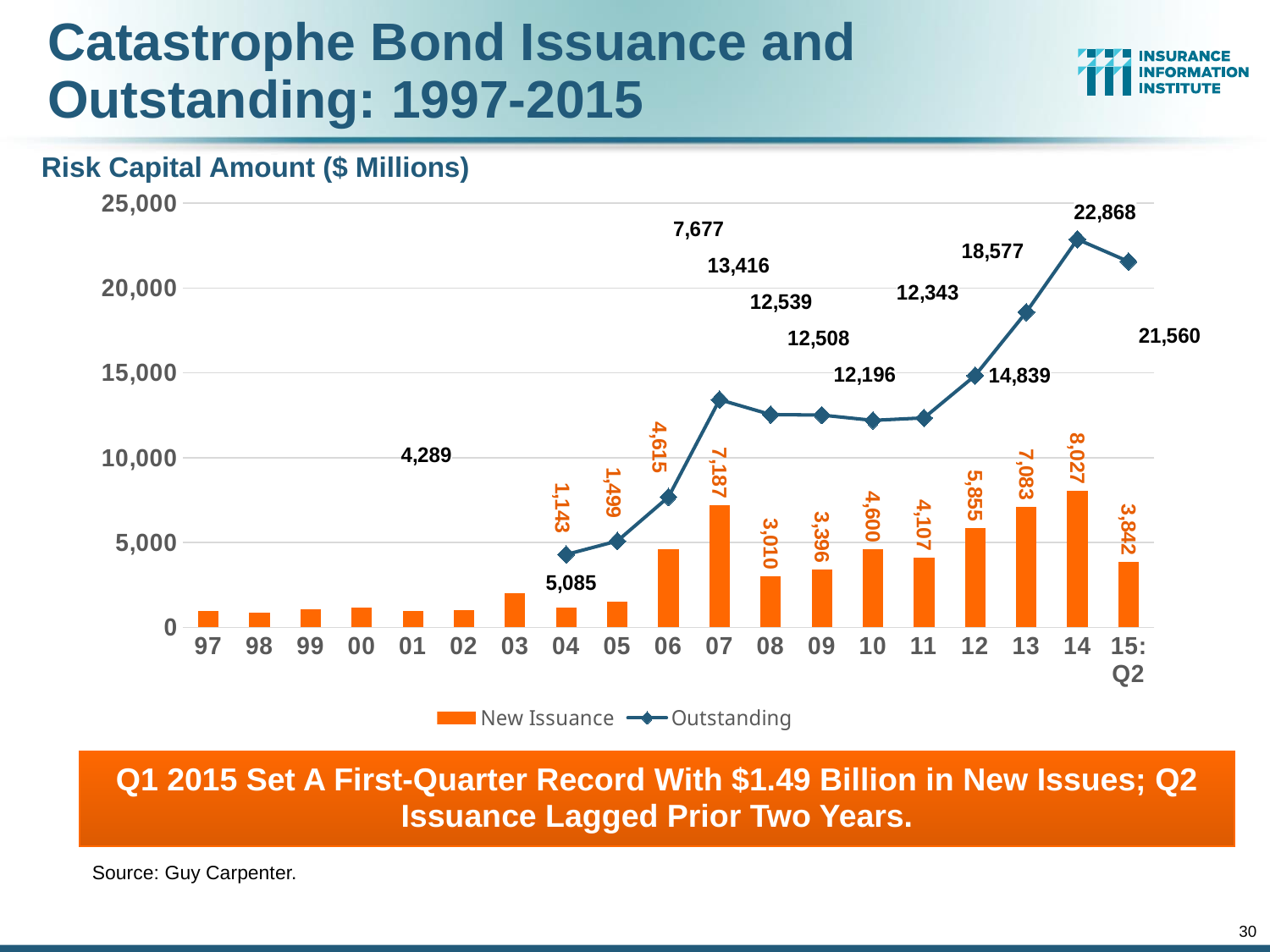
What was the New Issuance value for 15:Q2? 3,842 What was the Outstanding value in 2014? 22,868 Which is larger, the New Issuance value in 2012 or in 2013? 2013 Does the Outstanding line rise or fall from 2011 to 2014? rise What kind of chart is shown on the slide? A combined bar and line chart What is the difference between the Outstanding value in 2014 and in 15:Q2? 1,308 Which year has the highest New Issuance value? 14 Is the New Issuance value for 2003 greater or less than 5,000? less Which year has the lowest labeled Outstanding value? 04 What are the two series named in the legend? New Issuance and Outstanding How many series does the legend list? 2 What was the New Issuance value in 2014? 8,027